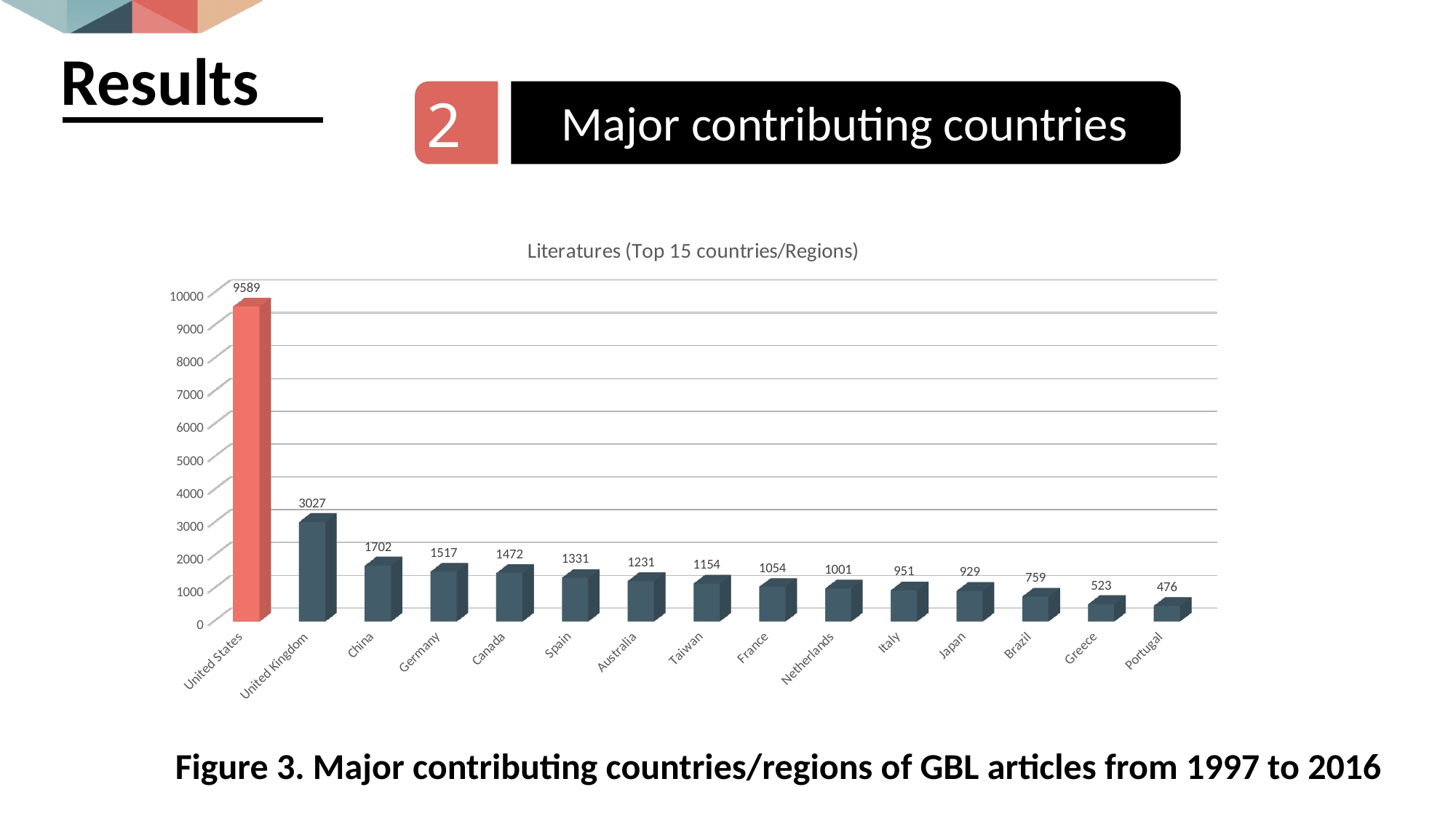
What is the value for Germany? 1517 What is the value for the United States? 9589 What is the difference between the values for the United States and the United Kingdom? 6562 Which country has the highest value? United States Which has a larger value, Spain or Taiwan? Spain Do the values rise or fall from left to right along the x axis? Fall How many countries/regions are shown in the chart? 15 Which country has the lowest value? Portugal What is the value for Netherlands? 1001 What kind of chart is shown on the slide? Bar chart What is the title of the chart? Literatures (Top 15 countries/Regions) What is the difference between the values for China and Canada? 230